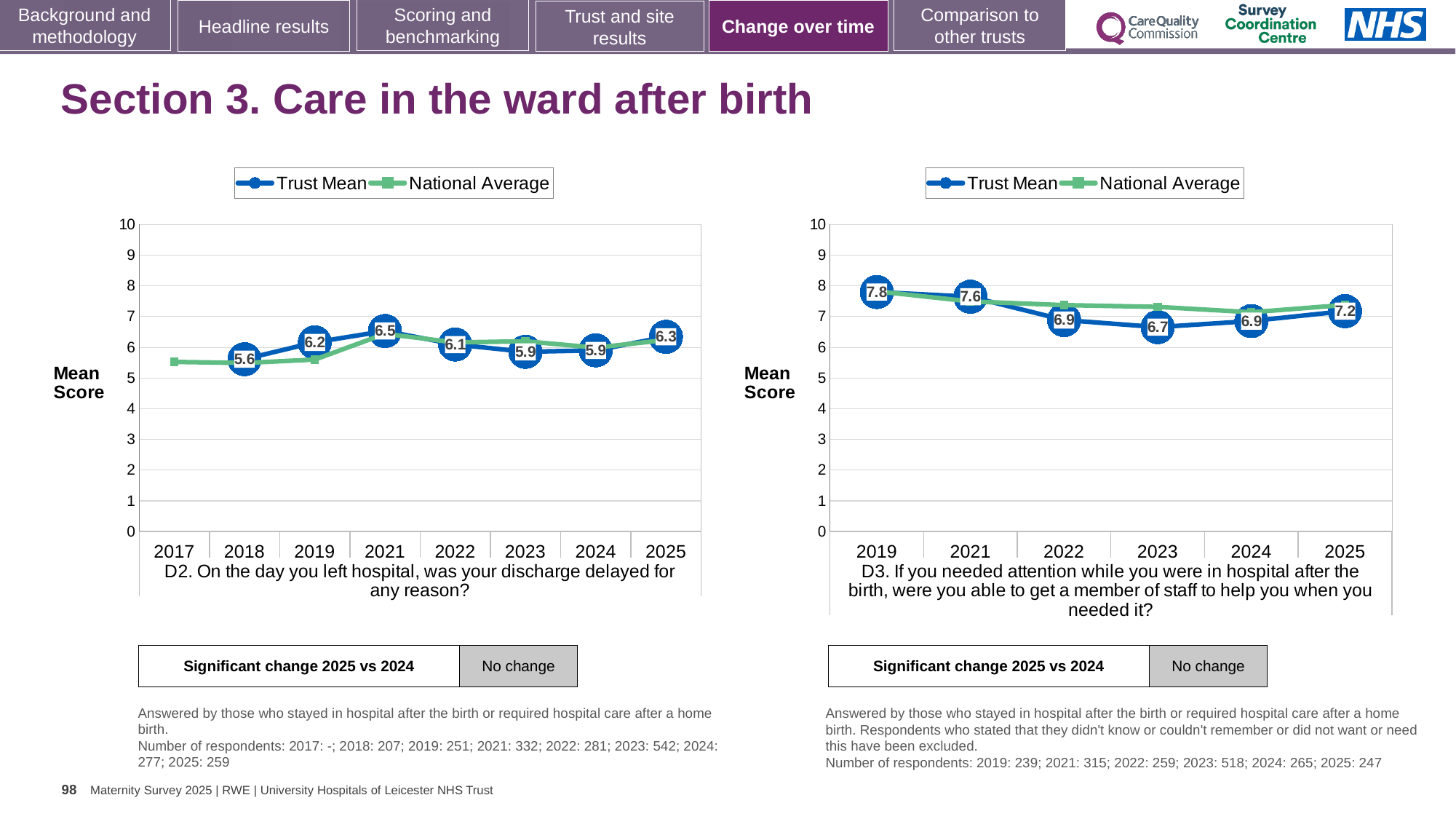
In the D2 chart (left), what is the Trust Mean for 2025? 6.3 In the D2 chart (left), what is the difference between the Trust Mean in 2025 and in 2024? 0.4 In the D3 chart (right), which year has the lowest Trust Mean? 2023 What kind of chart is the D2 chart (left)? line chart In the D3 chart (right), what is the Trust Mean for 2019? 7.8 In the D3 chart (right), what is the difference between the Trust Mean in 2019 and in 2023? 1.1 In the D2 chart (left), which year has the highest Trust Mean? 2021 In the D3 chart (right), is the Trust Mean higher in 2021 or in 2025? 2021 How many series does the legend of the D3 chart (right) list? 2 In the D2 chart (left), what is the Trust Mean for 2021? 6.5 In the D2 chart (left), how many years are shown on the x axis? 8 In the D3 chart (right), does the Trust Mean rise or fall from 2019 to 2023? fall